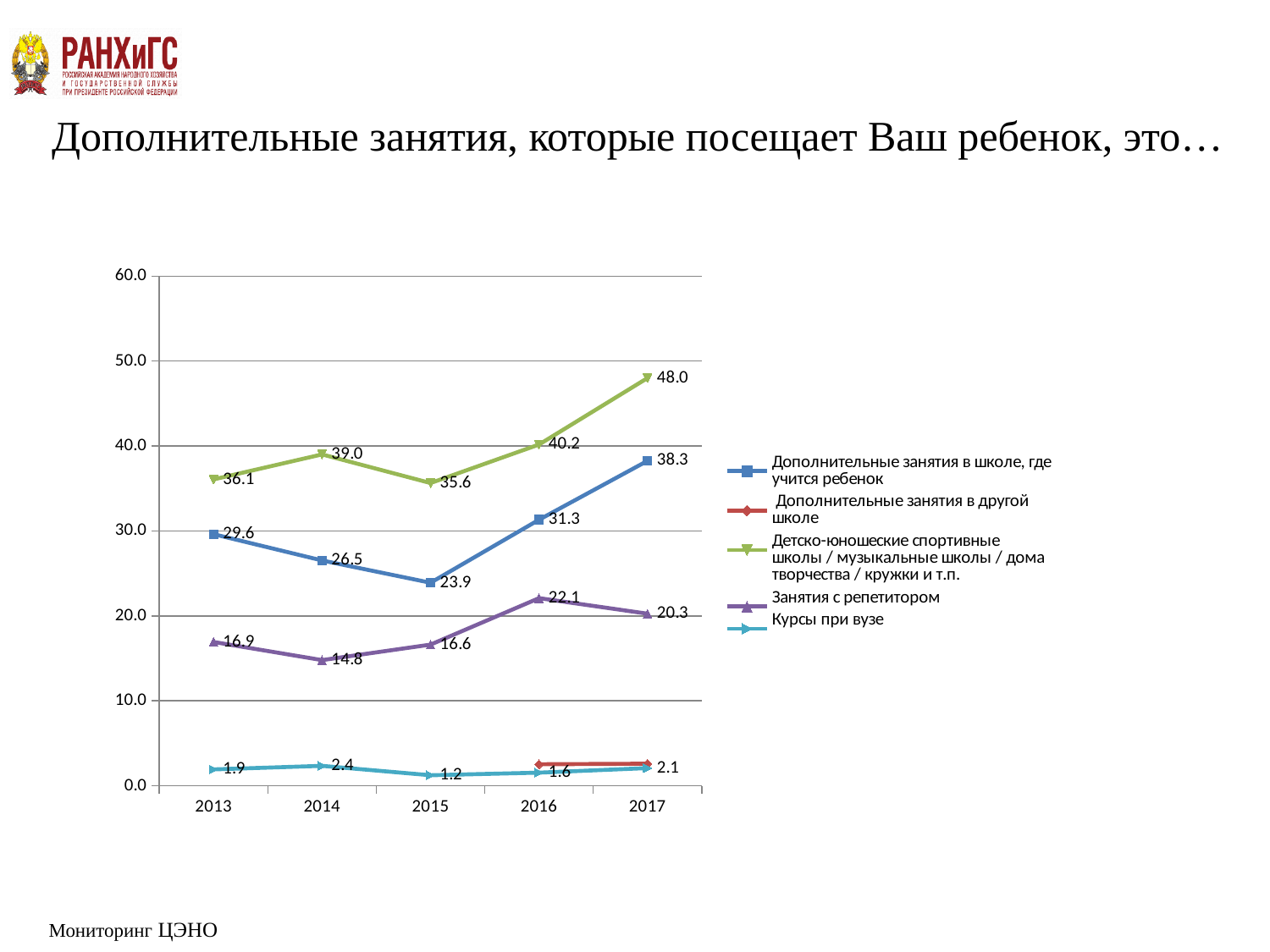
What is the value for «Дополнительные занятия в школе, где учится ребенок» in 2015? 23.9 In which year is the value for «Занятия с репетитором» highest? 2016 What is the value for «Занятия с репетитором» in 2016? 22.1 What is the value for «Курсы при вузе» in 2014? 2.4 Which series has the higher value in 2014: «Детско-юношеские спортивные школы / музыкальные школы / дома творчества / кружки и т.п.» or «Дополнительные занятия в школе, где учится ребенок»? Детско-юношеские спортивные школы / музыкальные школы / дома творчества / кружки и т.п. How many years are shown on the x axis? 5 Is the value for «Занятия с репетитором» in 2014 greater or less than 20.0? less In which year is the value for «Дополнительные занятия в школе, где учится ребенок» lowest? 2015 What is the value for «Детско-юношеские спортивные школы / музыкальные школы / дома творчества / кружки и т.п.» in 2017? 48.0 How many series does the legend list? 5 What type of chart is shown on the slide? line chart What is the difference between the 2017 and 2013 values for «Дополнительные занятия в школе, где учится ребенок»? 8.7